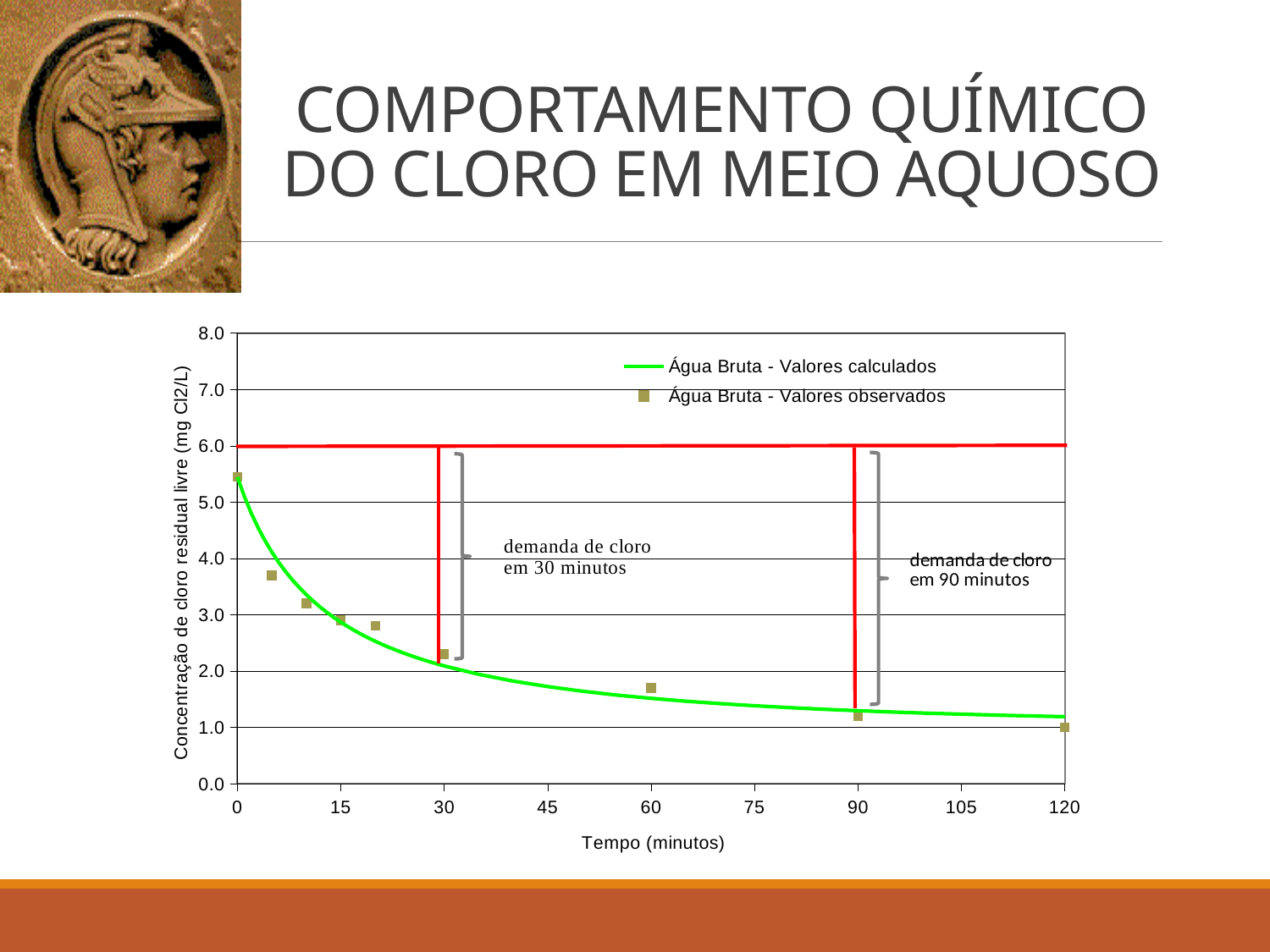
Is the observed value at 0 minutes greater or less than 5.0? greater What is the title of the x axis? Tempo (minutos) Is the observed value at 90 minutes greater or less than 2.0? less What are the two series named in the legend? Água Bruta - Valores calculados; Água Bruta - Valores observados At which time is the observed chlorine concentration highest? 0 minutes Which is larger, the observed value at 5 minutes or at 60 minutes? 5 minutes How many series does the chart legend list? 2 Is the observed value at 5 minutes greater or less than 3.0? greater Do the calculated values rise or fall as time increases along the x axis? fall At which time is the observed chlorine concentration lowest? 120 minutes What kind of chart is shown on the slide? line chart